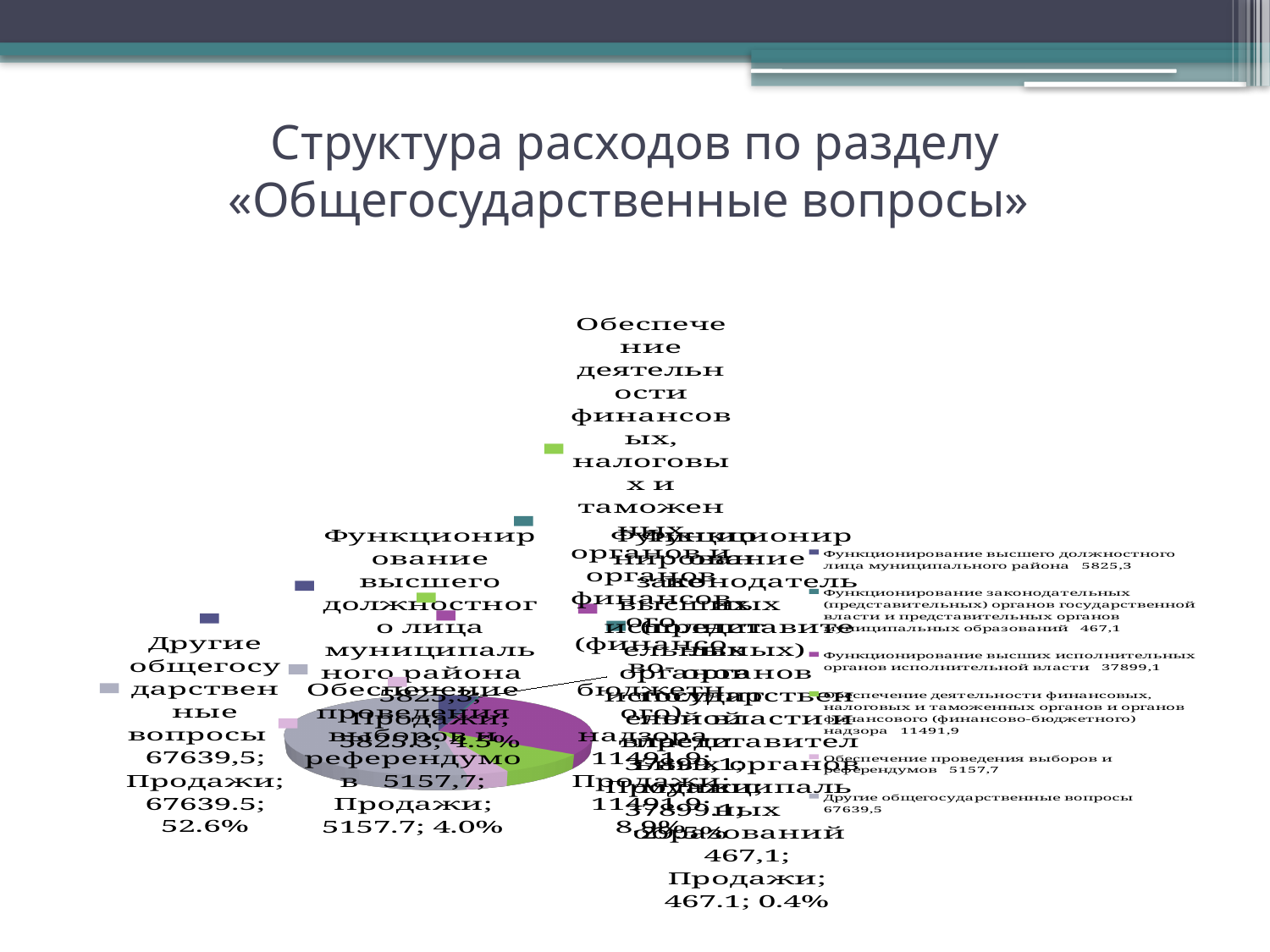
What is the value for «Обеспечение проведения выборов и референдумов»? 5157,7 What is the value for «Другие общегосударственные вопросы»? 67639,5 What is the value for «Функционирование высших исполнительных органов исполнительной власти»? 37899,1 What is the value for «Функционирование высшего должностного лица муниципального района»? 5825,3 Which category has the smallest value in the pie chart? Функционирование законодательных (представительных) органов государственной власти и представительных органов муниципальных образований Which is larger: the value for «Функционирование высшего должностного лица муниципального района» or for «Обеспечение проведения выборов и референдумов»? Функционирование высшего должностного лица муниципального района What share of the pie does «Другие общегосударственные вопросы» take? 52.6% How many categories does the legend of the pie chart list? 6 What is the title of the slide's chart? Структура расходов по разделу «Общегосударственные вопросы» Which category has the largest value in the pie chart? Другие общегосударственные вопросы What kind of chart is shown on the slide? Pie chart What is the difference between the values for «Другие общегосударственные вопросы» and «Функционирование высших исполнительных органов исполнительной власти»? 29740,4